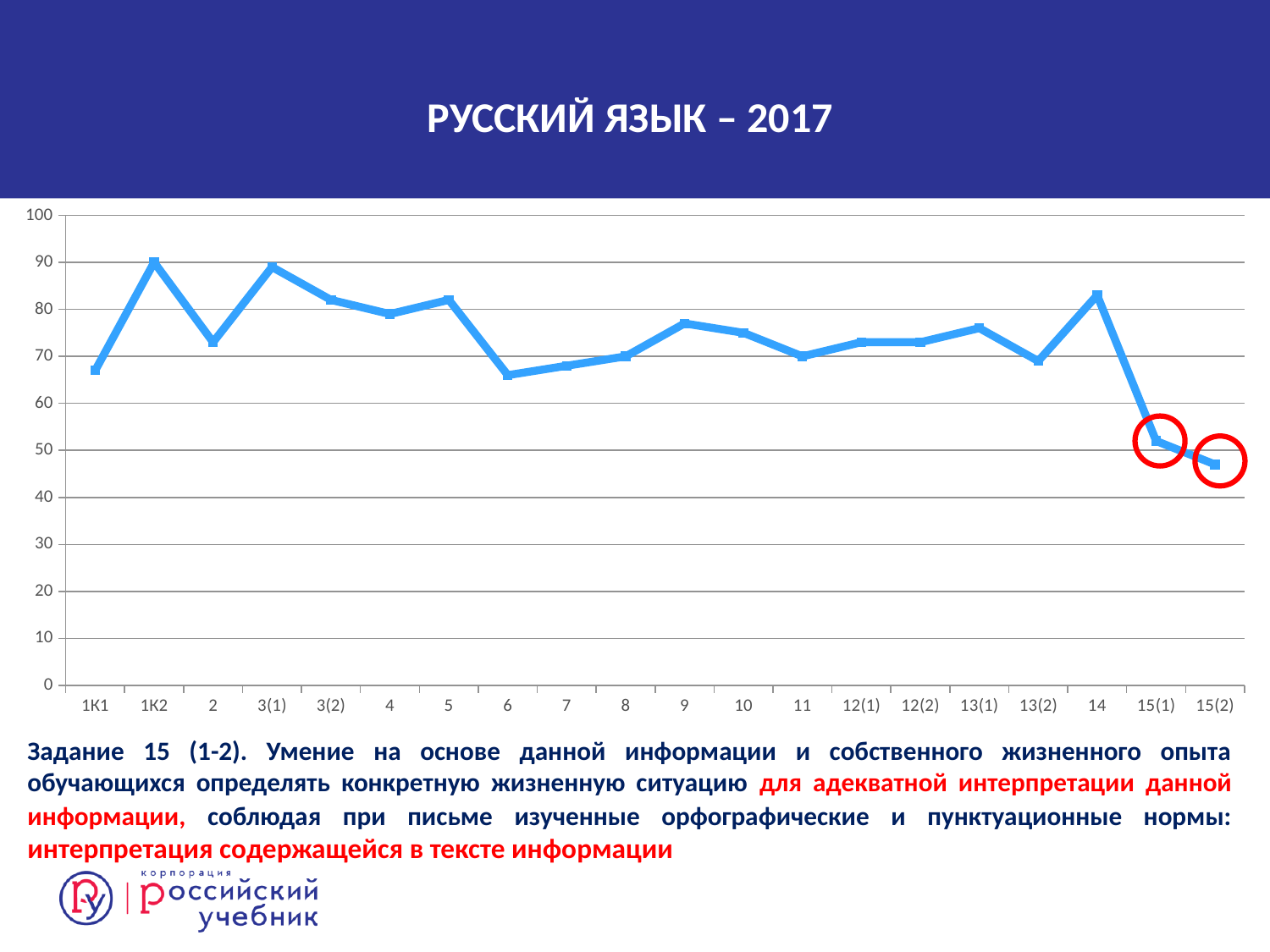
Do the values rise or fall from category 14 to category 15(2)? fall Is the value for 1К2 greater or less than 80? greater Which category has the lowest value on the chart? 15(2) Is the value for 14 greater or less than 80? greater How many categories are plotted along the x axis of the chart? 20 Which has the larger value, 1К2 or 2? 1К2 Is the value for 6 greater or less than 70? less Which has the larger value, 14 or 15(1)? 14 What kind of chart is shown on the slide? line chart Which two categories are circled in red on the chart? 15(1) and 15(2)